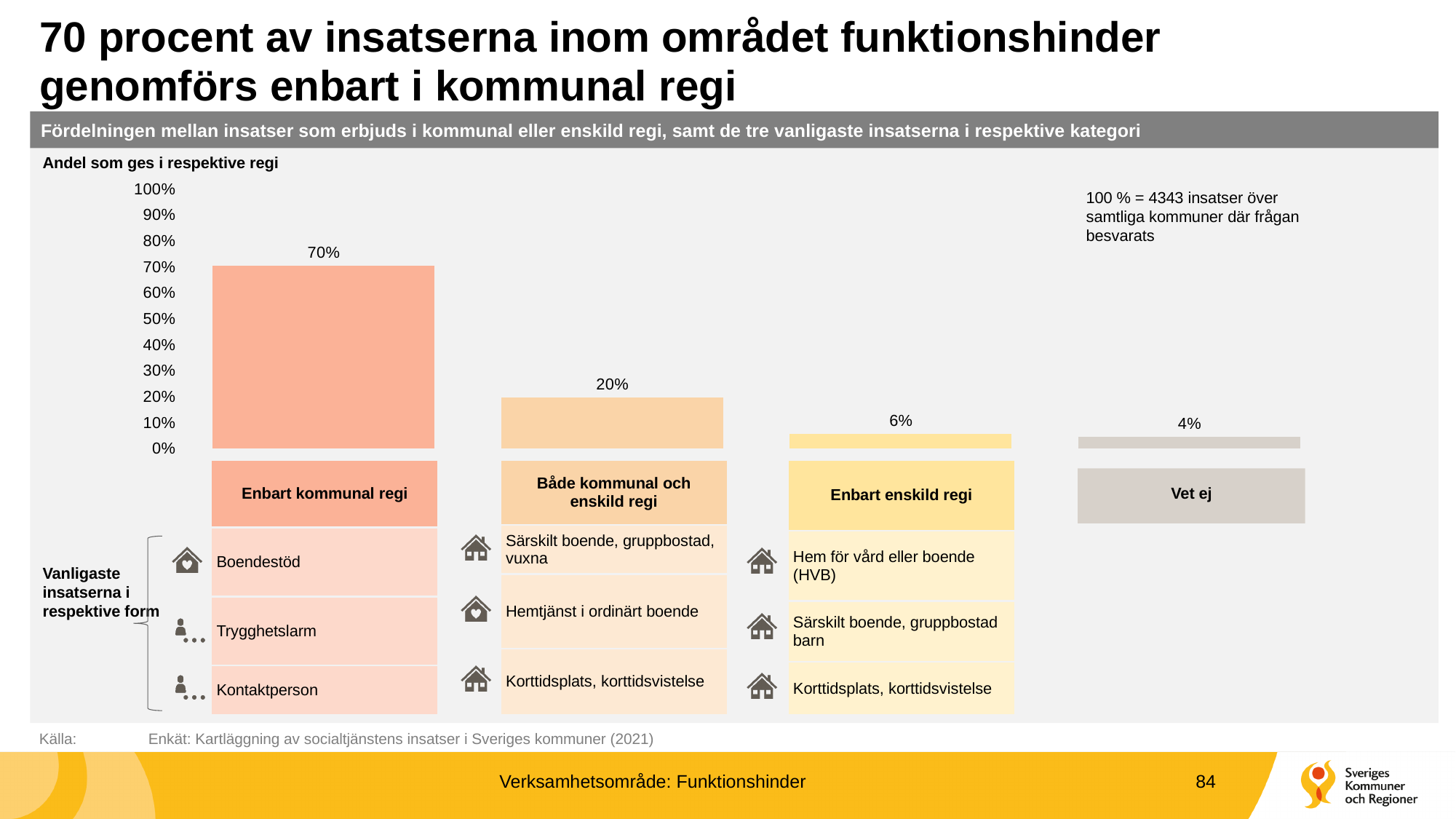
What is the label on the y axis of the chart? Andel som ges i respektive regi Which category has the lowest value? Vet ej What kind of chart is shown on the slide? bar chart What is the value for Enbart enskild regi? 6% What is the value for Både kommunal och enskild regi? 20% What is the value for Vet ej? 4% Which category has the highest value? Enbart kommunal regi Is the value for Både kommunal och enskild regi greater or less than 30%? less Which is larger, the value for Enbart enskild regi or the value for Vet ej? Enbart enskild regi What is the difference between the values for Enbart kommunal regi and Både kommunal och enskild regi? 50 percentage points What is the value for Enbart kommunal regi? 70% How many categories are shown in the chart? 4